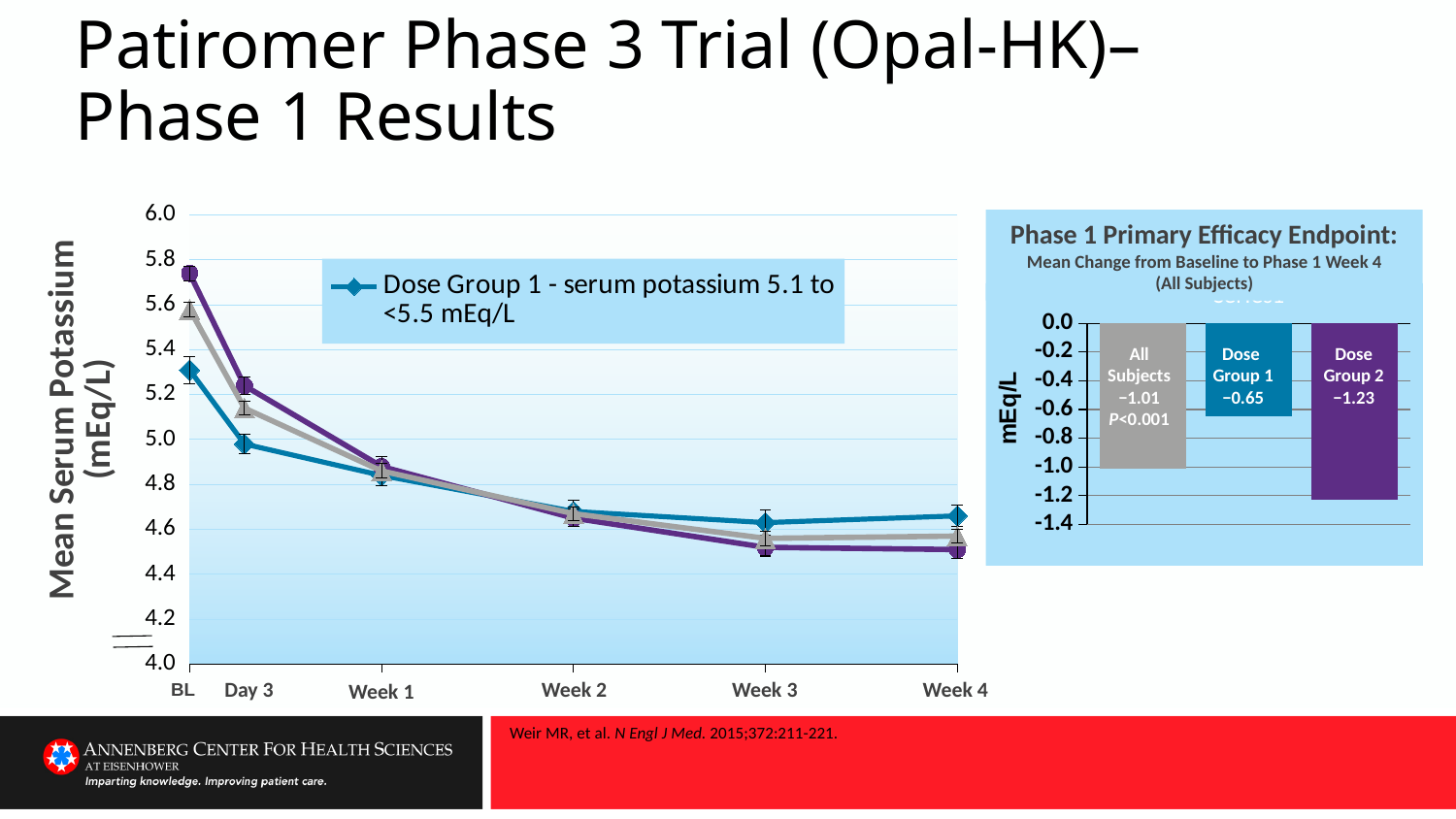
In the bar chart titled 'Phase 1 Primary Efficacy Endpoint', what P value is printed for All Subjects? P<0.001 In the line chart on the left, do the serum potassium values rise or fall from BL to Week 4? Fall In the bar chart titled 'Phase 1 Primary Efficacy Endpoint', how many bars are shown? 3 In the bar chart titled 'Phase 1 Primary Efficacy Endpoint', which group shows the smallest decrease (highest value)? Dose Group 1 In the bar chart titled 'Phase 1 Primary Efficacy Endpoint', what is the mean change from baseline for Dose Group 2? −1.23 In the bar chart titled 'Phase 1 Primary Efficacy Endpoint', what is the mean change from baseline for Dose Group 1? −0.65 In the bar chart titled 'Phase 1 Primary Efficacy Endpoint', what is the mean change from baseline for All Subjects? −1.01 In the bar chart titled 'Phase 1 Primary Efficacy Endpoint', which group shows the largest decrease (lowest value)? Dose Group 2 In the line chart on the left, is the value for Dose Group 1 at BL greater or less than 5.0? greater In the bar chart titled 'Phase 1 Primary Efficacy Endpoint', what is the difference between the values for Dose Group 2 and Dose Group 1? 0.58 In the line chart on the left, how many time points are shown on the x axis? 6 What kind of chart is the chart on the right side of the slide? Bar chart